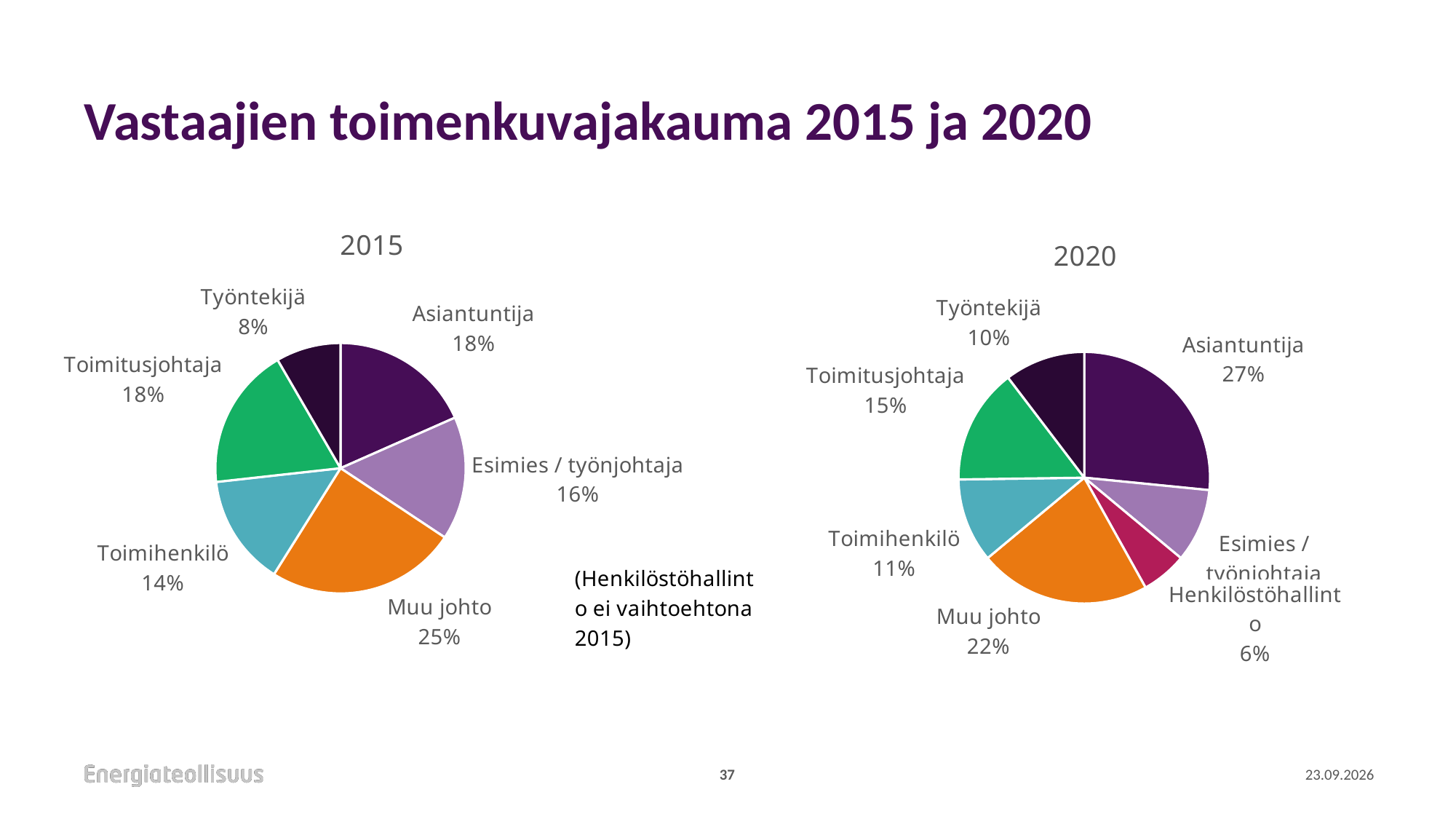
What is the difference between the Asiantuntija share in 2020 and in 2015? 9 percentage points In the 2020 chart, which category has the largest share? Asiantuntija In the 2015 chart, what share is Muu johto? 25% What kind of charts are shown on the slide? Pie charts In the 2015 chart, which category has the largest share? Muu johto In the 2015 chart, which category has the smallest share? Työntekijä In the 2015 chart, what share is Työntekijä? 8% In the 2020 chart, what share is Toimitusjohtaja? 15% How many slices does the 2015 pie chart have? 6 How many slices does the 2020 pie chart have? 7 In the 2020 chart, what share is Asiantuntija? 27% In the 2020 chart, which is larger: Muu johto or Toimihenkilö? Muu johto